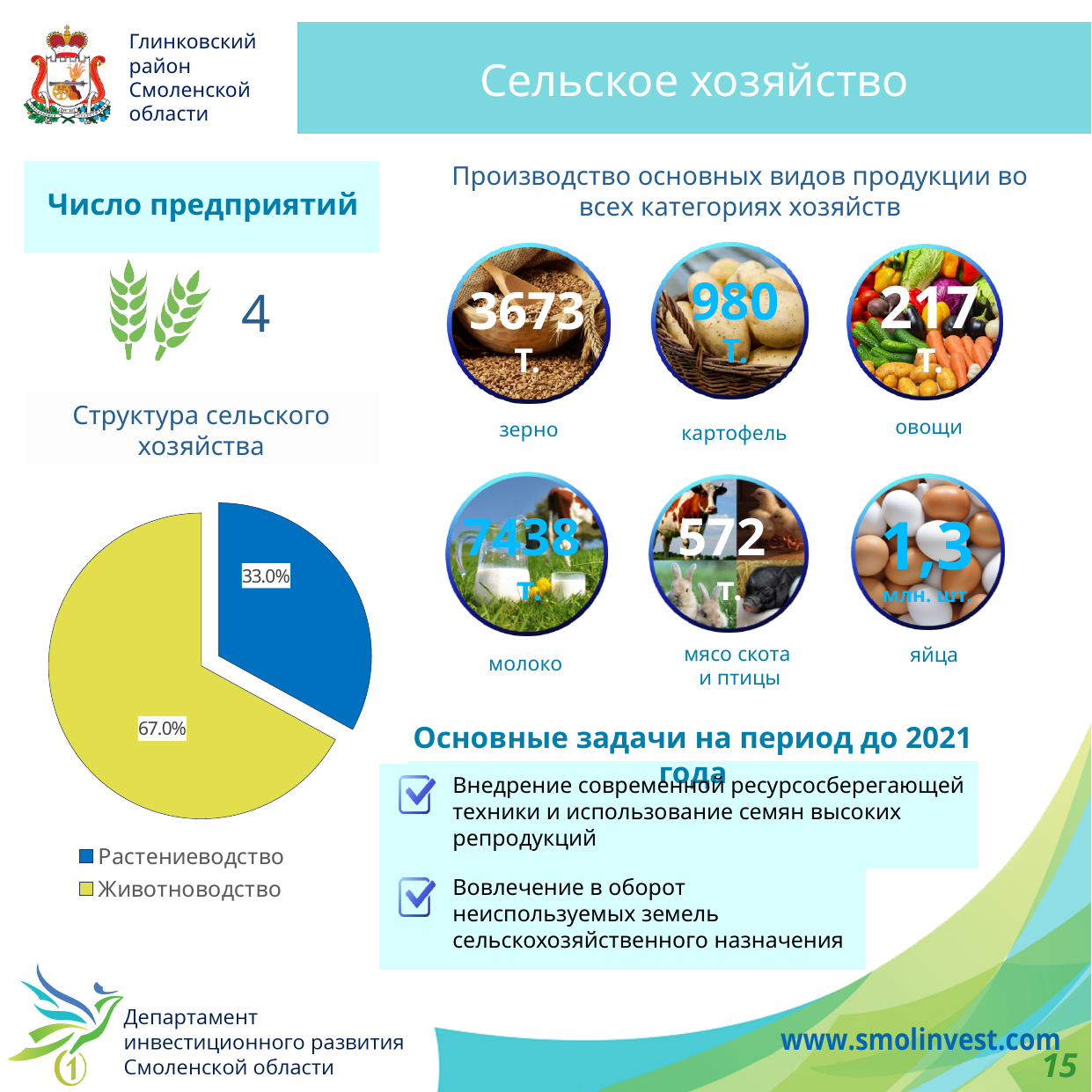
In the pie chart "Структура сельского хозяйства", what share is labelled for Растениеводство? 33.0% In the pie chart "Структура сельского хозяйства", what colour is the Растениеводство slice? blue How many slices does the pie chart "Структура сельского хозяйства" have? 2 In the pie chart "Структура сельского хозяйства", which is larger: Растениеводство or Животноводство? Животноводство In the pie chart "Структура сельского хозяйства", is the share for Животноводство greater or less than 50%? greater In the pie chart "Структура сельского хозяйства", what colour is the Животноводство slice? yellow In the pie chart "Структура сельского хозяйства", which category has the smallest slice? Растениеводство In the pie chart "Структура сельского хозяйства", what is the difference in percentage points between Животноводство and Растениеводство? 34.0% What kind of chart is shown under the heading "Структура сельского хозяйства"? pie chart In the pie chart "Структура сельского хозяйства", which category has the largest slice? Животноводство How many entries does the legend of the pie chart "Структура сельского хозяйства" list? 2 In the pie chart "Структура сельского хозяйства", what share is labelled for Животноводство? 67.0%